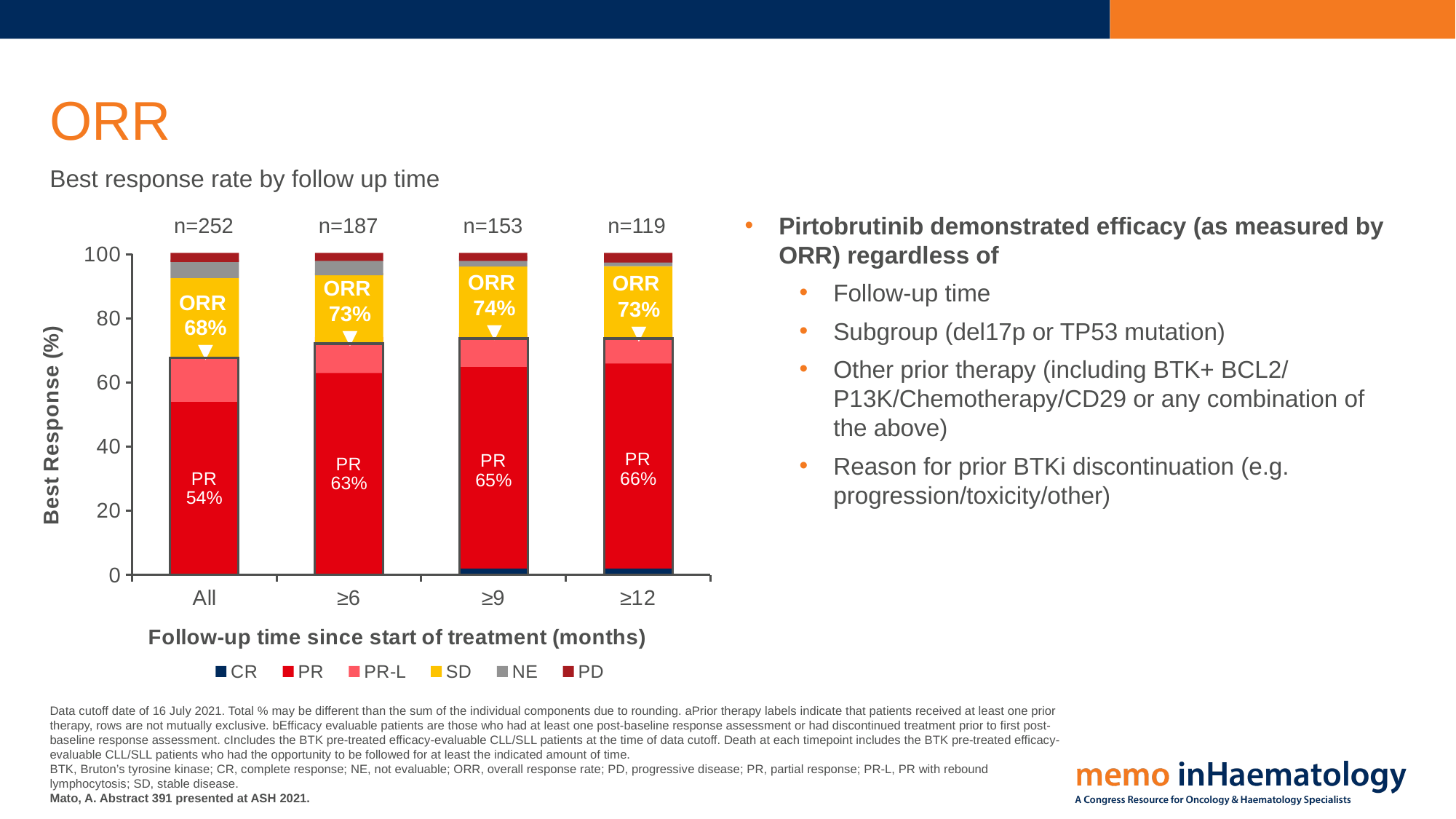
Which follow-up group has the lowest PR value? All How many series does the legend list? 6 What is the ORR for the ≥9 months follow-up group? 74% Which follow-up group has the highest ORR? ≥9 What is the PR value for the All group? 54% How many follow-up groups are shown on the x axis? 4 What is the difference in PR between the ≥12 group and the All group? 12 percentage points Which is larger, the PR value for ≥6 or for ≥9? ≥9 What is the n value shown above the ≥6 bar? n=187 Does the PR value rise or fall from All to ≥12 along the x axis? Rise What kind of chart is shown on the slide? Stacked bar chart What is the PR value for the ≥12 months follow-up group? 66%